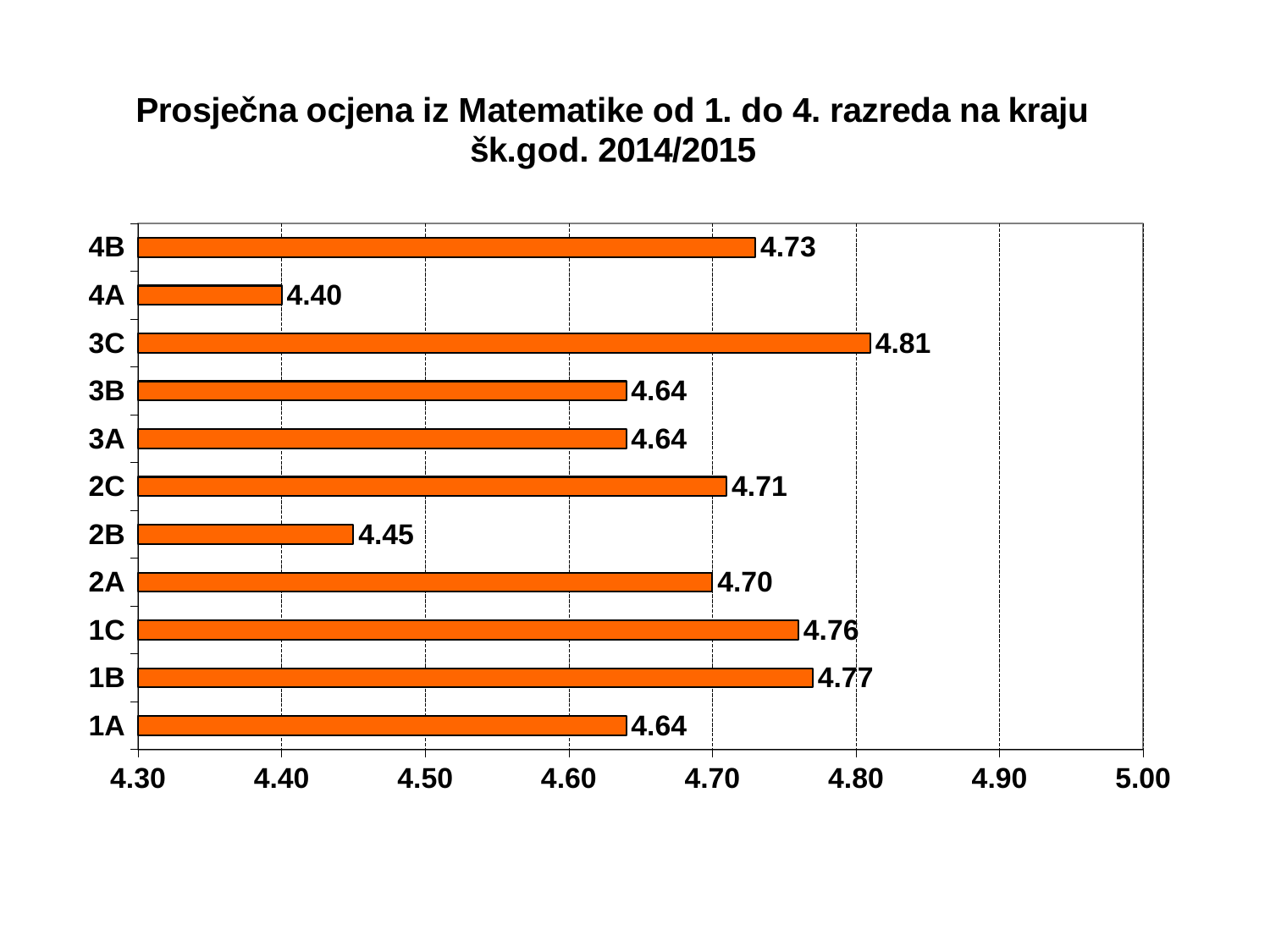
What is the value shown for class 1B? 4.77 How many classes are shown in the chart? 11 What is the value shown for class 2B? 4.45 What is the difference between the values for 3C and 4A? 0.41 Which class has the highest average grade? 3C Which class has the lowest average grade? 4A What is the difference between the values for 1B and 1C? 0.01 What is the title of the chart? Prosječna ocjena iz Matematike od 1. do 4. razreda na kraju šk.god. 2014/2015 Is the value for 4B greater or less than 4.70? greater Which has a higher value, 2C or 2A? 2C What is the average Mathematics grade for class 3C? 4.81 What kind of chart is this? bar chart